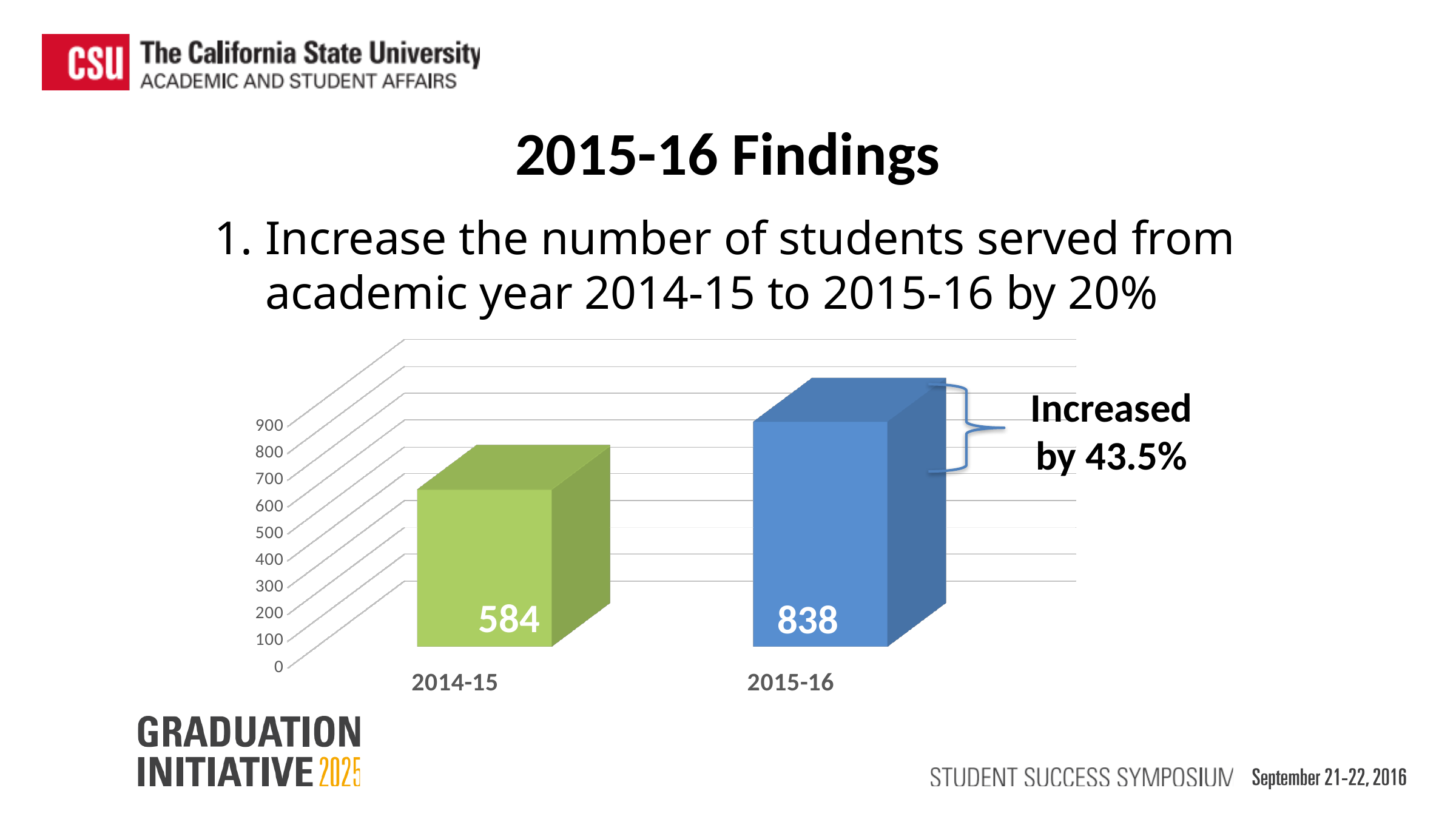
Which category has the lowest value? 2014-15 What is the value for 2015-16? 838 Which category has the highest value? 2015-16 Do the values rise or fall from 2014-15 to 2015-16? rise Is the value for 2015-16 greater or less than 900? less What kind of chart is shown on the slide? bar chart What is the difference between the values for 2015-16 and 2014-15? 254 What is the value for 2014-15? 584 Which is larger, the value for 2014-15 or the value for 2015-16? 2015-16 How many categories are shown on the x axis? 2 What percentage increase does the annotation next to the 2015-16 bar state? 43.5% Is the value for 2014-15 greater or less than 500? greater